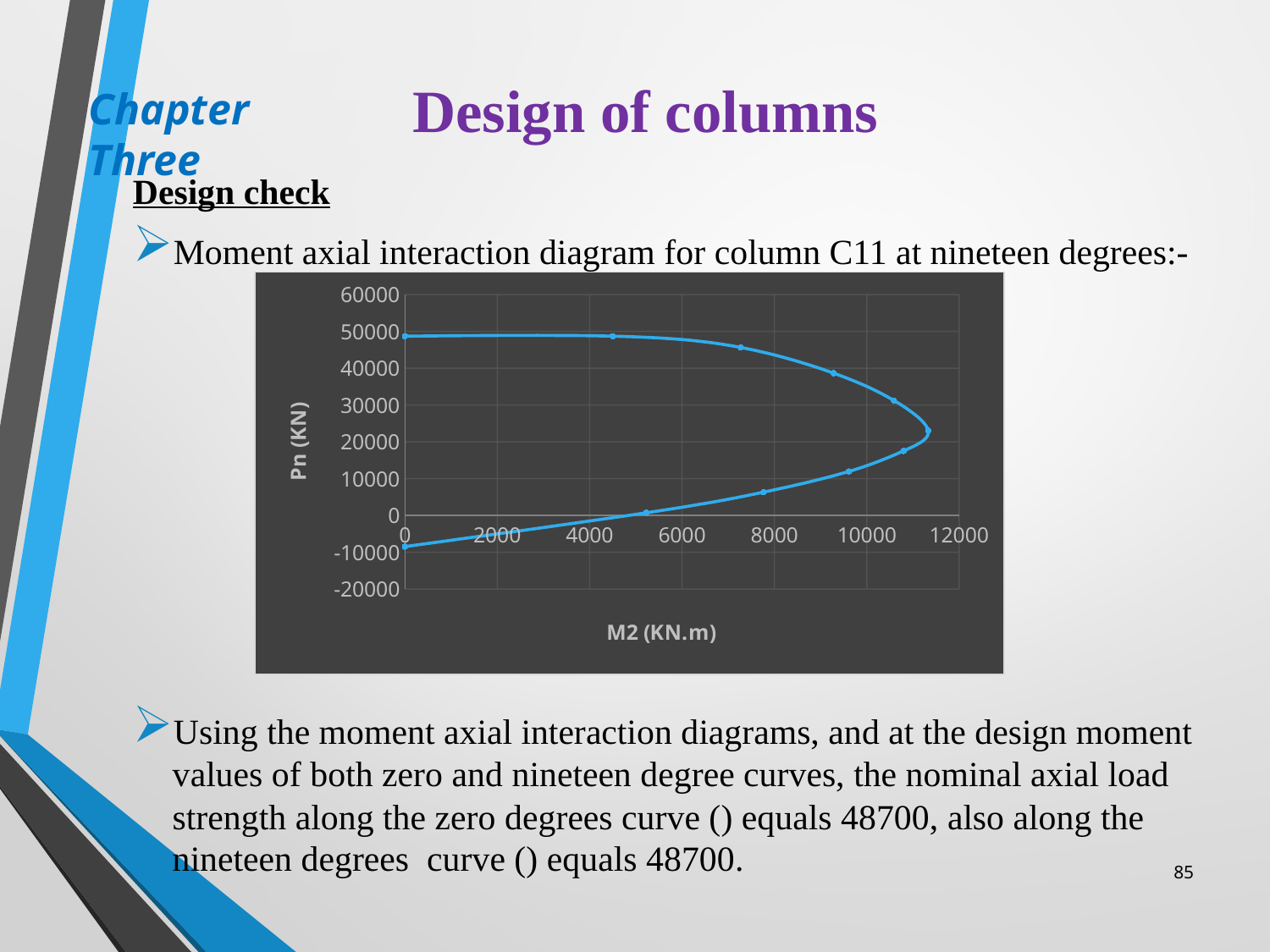
Is the lowest Pn value on the curve greater or less than 0? less Along the upper branch of the curve, does Pn rise or fall as M2 increases from 4000 to 10000? fall What is the title of the vertical axis of the chart? Pn (KN) What kind of chart is shown on the slide? Line chart Along the lower branch of the curve, does Pn rise or fall as M2 increases from 0 to 10000? rise Which is larger: the Pn value at M2 = 0 on the upper branch or the Pn value at M2 = 0 on the lower branch? the upper branch Is the highest Pn value on the curve greater or less than 40000? greater Is the lowest Pn value on the curve greater or less than -20000? greater What is the title of the horizontal axis of the chart? M2 (KN.m) What is the maximum value shown on the vertical axis of the chart? 60000